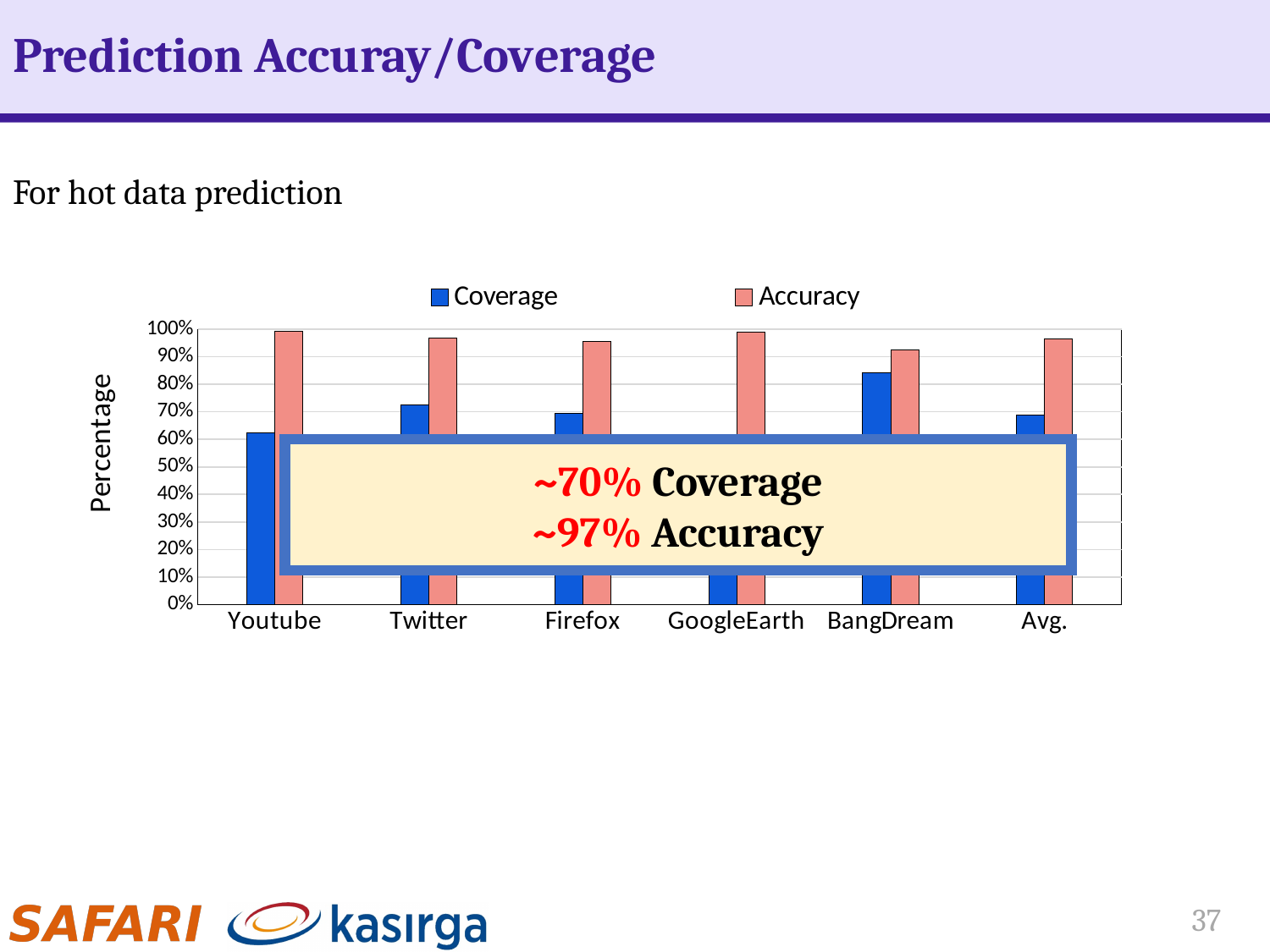
Which category has the highest Coverage value? BangDream How many categories are shown on the x axis? 6 Is the Coverage value for Twitter greater or less than 80%? less Which is larger, the Coverage value for BangDream or the Coverage value for Twitter? BangDream Which category has the lowest Accuracy value? BangDream Which is larger, the Accuracy value for Youtube or the Accuracy value for BangDream? Youtube Is the Accuracy value for BangDream greater or less than 90%? greater What is the label on the y axis of the chart? Percentage How many series does the legend list? 2 Is the Coverage value for BangDream greater or less than 80%? greater What kind of chart is shown on the slide? bar chart